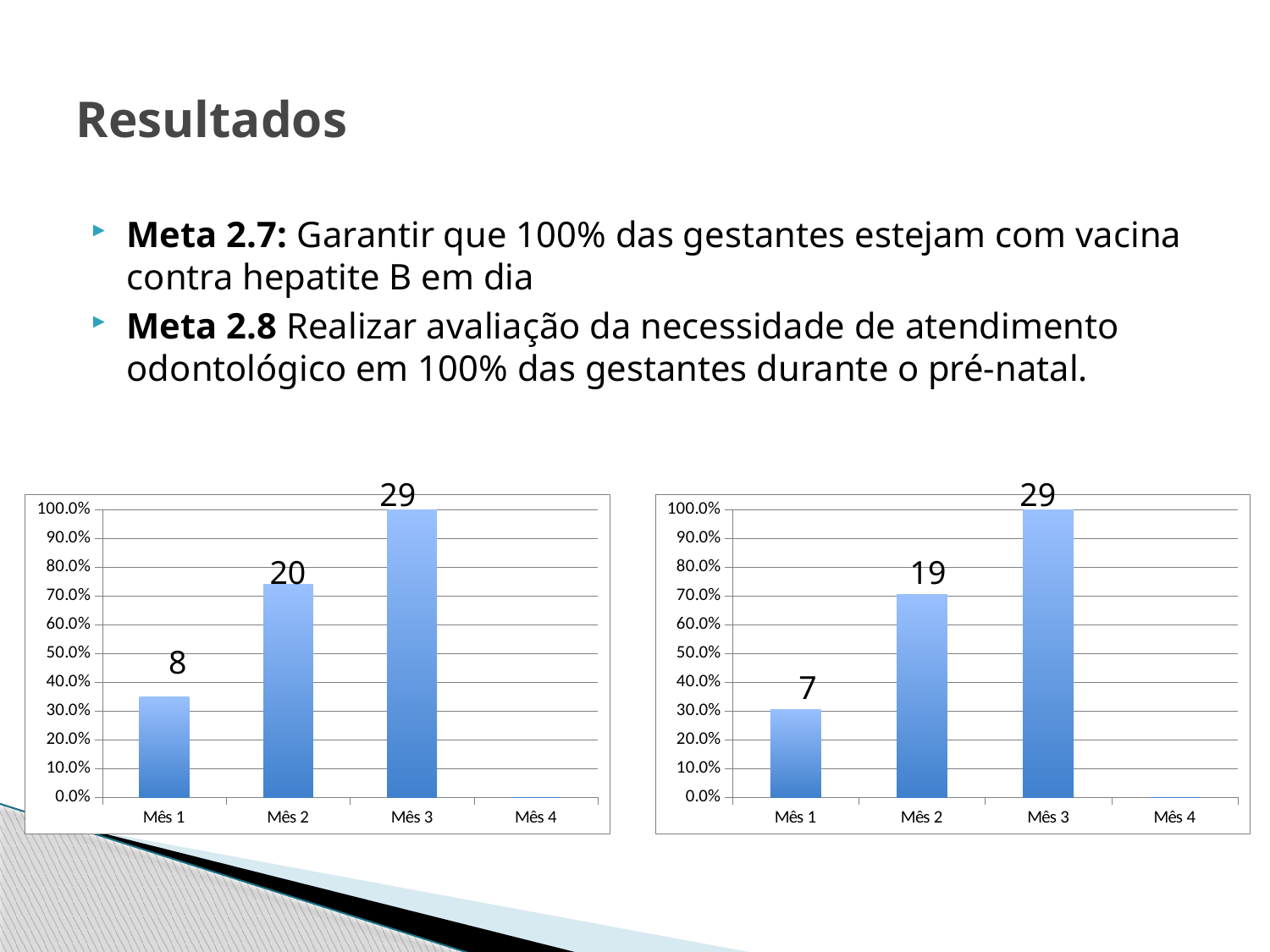
In the right chart, what is the data label shown for Mês 1? 7 In the right chart, which is larger, the value for Mês 2 or the value for Mês 3? Mês 3 In the left chart, which month has the highest bar? Mês 3 How many months are shown on the x axis of the left chart? 4 In the left chart, what is the difference between the data labels for Mês 3 and Mês 1? 21 In the left chart, what is the data label shown for Mês 2? 20 In the right chart, which month has the lowest bar? Mês 4 What type of chart is the right chart? Bar chart In the right chart, is the bar for Mês 2 greater or less than 60.0%? greater In the right chart, what is the difference between the data labels for Mês 2 and Mês 1? 12 In the left chart, what percentage does the bar for Mês 3 reach on the y axis? 100.0% In the left chart, is the bar for Mês 1 greater or less than 40.0%? less